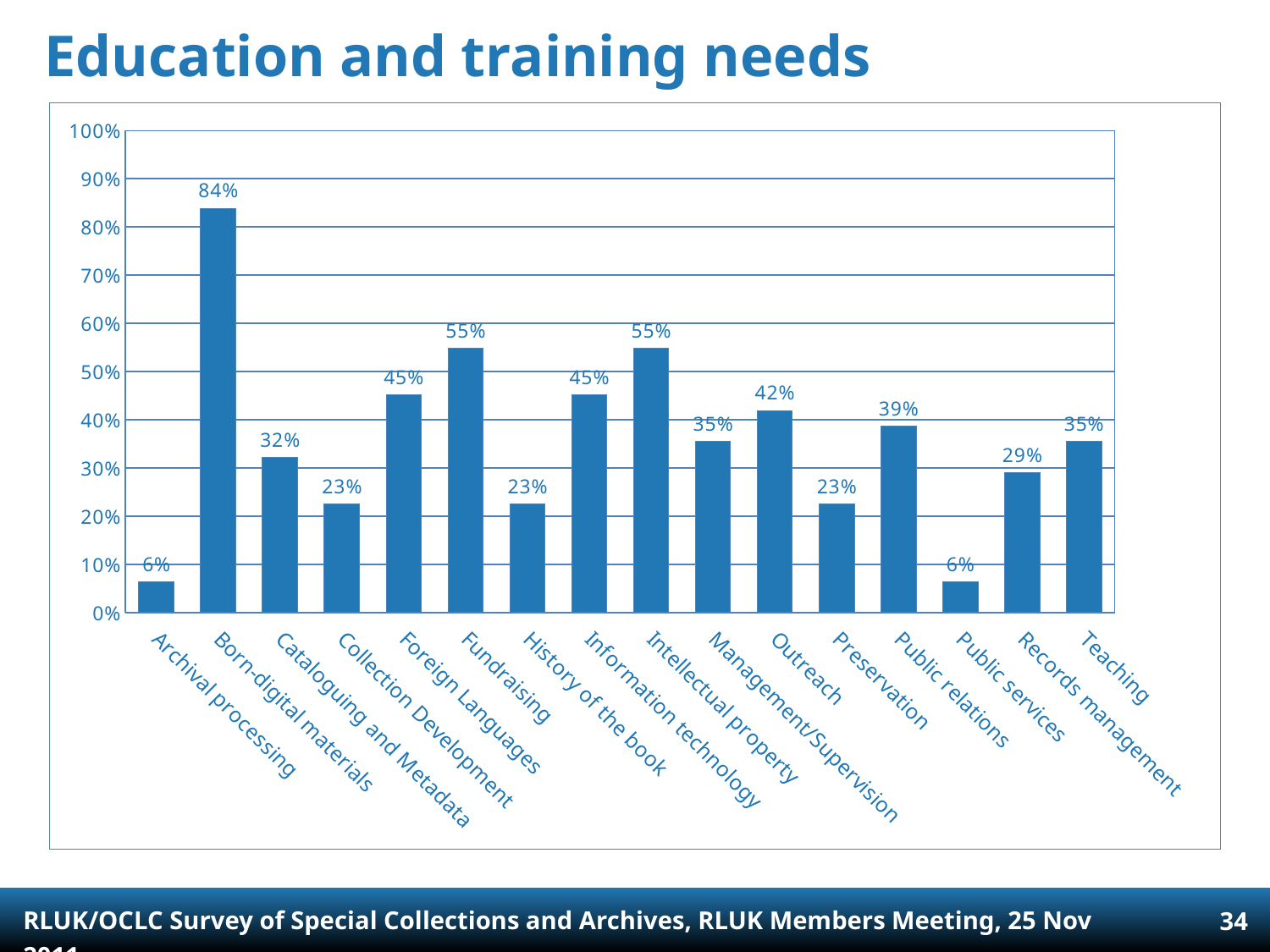
What is the value for Public relations? 39% What is the value for Born-digital materials? 84% What is the title of the slide? Education and training needs What kind of chart is shown on the slide? Bar chart Which is larger, the value for Outreach or the value for Teaching? Outreach What is the value for Records management? 29% What is the value for Outreach? 42% How many categories are shown on the x axis? 16 What is the difference between the values for Born-digital materials and Cataloguing and Metadata? 52% Which category has the highest value? Born-digital materials Which is larger, the value for Preservation or the value for Records management? Records management What is the difference between the values for Fundraising and Foreign Languages? 10%